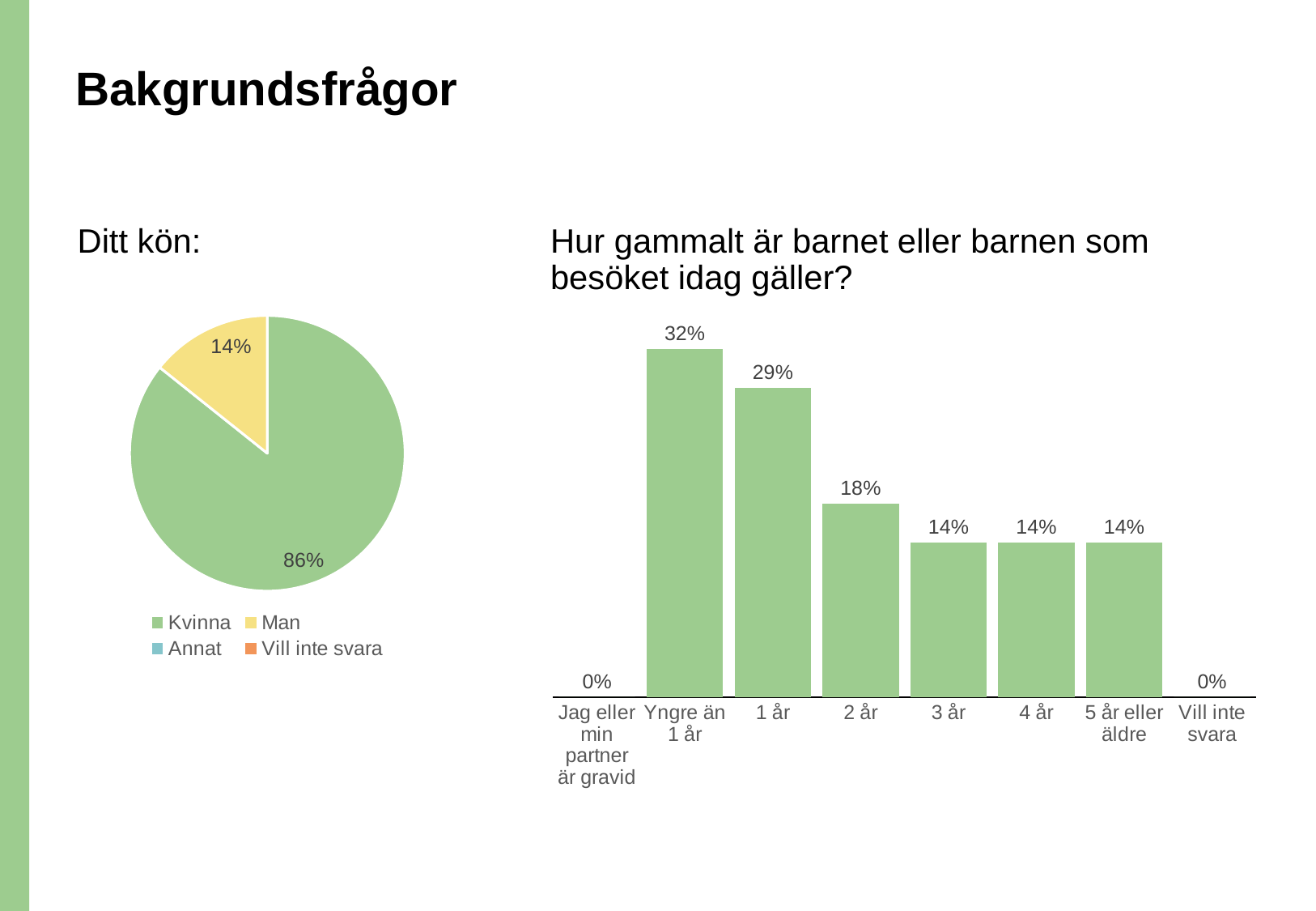
In the 'Hur gammalt är barnet eller barnen som besöket idag gäller?' chart, which is larger: the value for '1 år' or '2 år'? 1 år How many entries does the legend of the 'Ditt kön:' pie chart list? 4 In the 'Ditt kön:' pie chart, what share is labelled for Man? 14% In the 'Ditt kön:' pie chart, what share is labelled for Kvinna? 86% How many categories are shown on the x axis of the 'Hur gammalt är barnet eller barnen som besöket idag gäller?' chart? 8 What kind of chart is the 'Ditt kön:' chart? Pie chart In the 'Hur gammalt är barnet eller barnen som besöket idag gäller?' chart, which category has the highest value? Yngre än 1 år In the 'Hur gammalt är barnet eller barnen som besöket idag gäller?' chart, what is the difference between the values for 'Yngre än 1 år' and '1 år'? 3% In the 'Hur gammalt är barnet eller barnen som besöket idag gäller?' chart, what is the value for 'Yngre än 1 år'? 32% In the 'Hur gammalt är barnet eller barnen som besöket idag gäller?' chart, what is the value for 'Vill inte svara'? 0% What kind of chart is the 'Hur gammalt är barnet eller barnen som besöket idag gäller?' chart? Bar chart In the 'Hur gammalt är barnet eller barnen som besöket idag gäller?' chart, what is the value for '2 år'? 18%